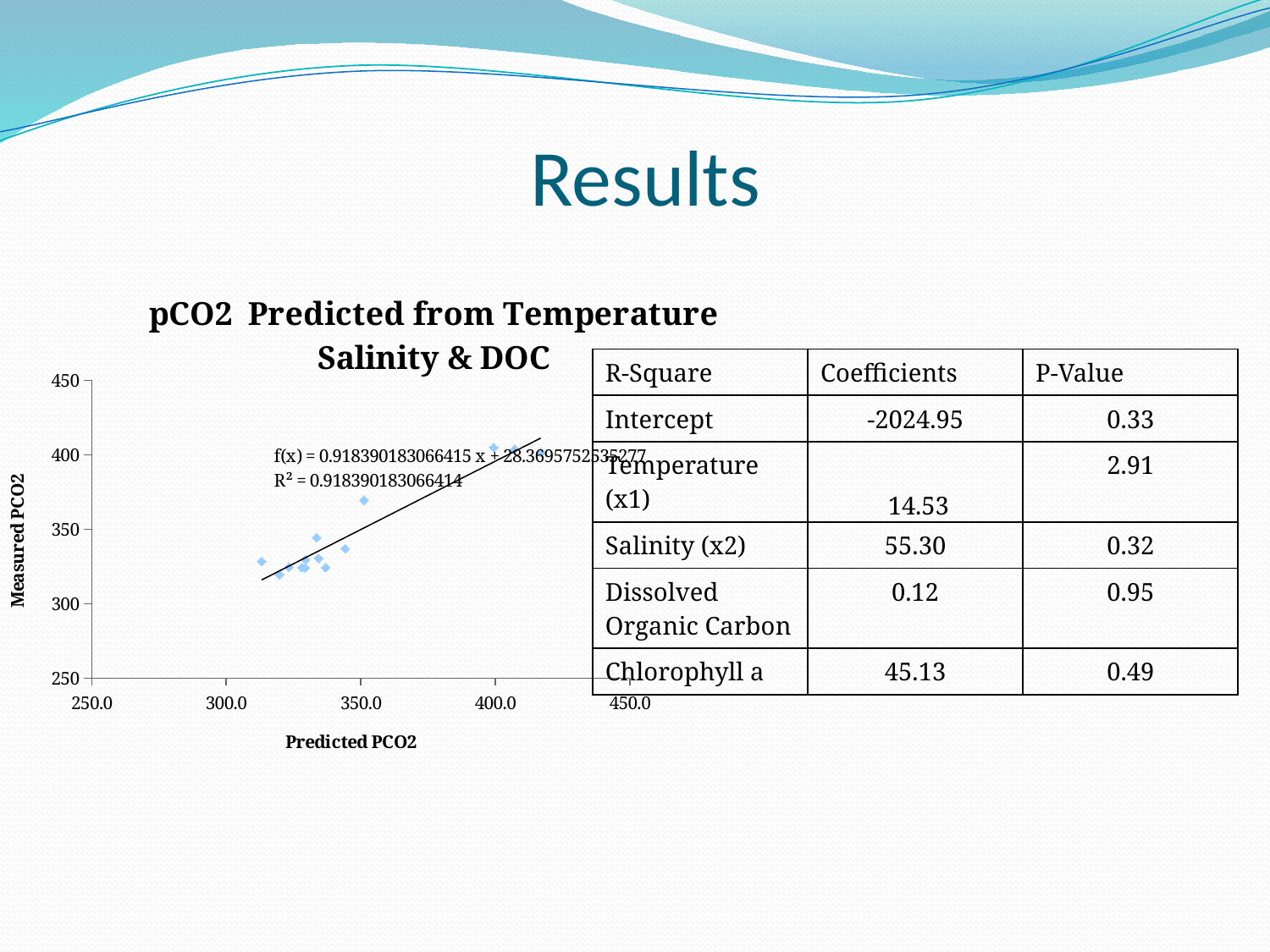
What is the lowest tick value shown on the y axis of the chart? 250 Is the Measured PCO2 value of the lowest plotted point greater or less than 300? greater Is the Predicted PCO2 value of the rightmost plotted point greater or less than 350.0? greater What kind of chart is shown on the slide? scatter chart What is the slope of the trendline shown on the chart? 0.918390183066415 What is the highest tick value shown on the x axis of the chart? 450.0 What is the title of the chart? pCO2 Predicted from Temperature Salinity & DOC What is the trendline equation printed on the chart? f(x) = 0.918390183066415 x + 28.3695752535277 Is the Measured PCO2 value of the lowest plotted point greater or less than 350? less Do the plotted points rise or fall as Predicted PCO2 increases along the x axis? rise What is the label of the x axis of the chart? Predicted PCO2 What R² value is printed on the chart? 0.918390183066414